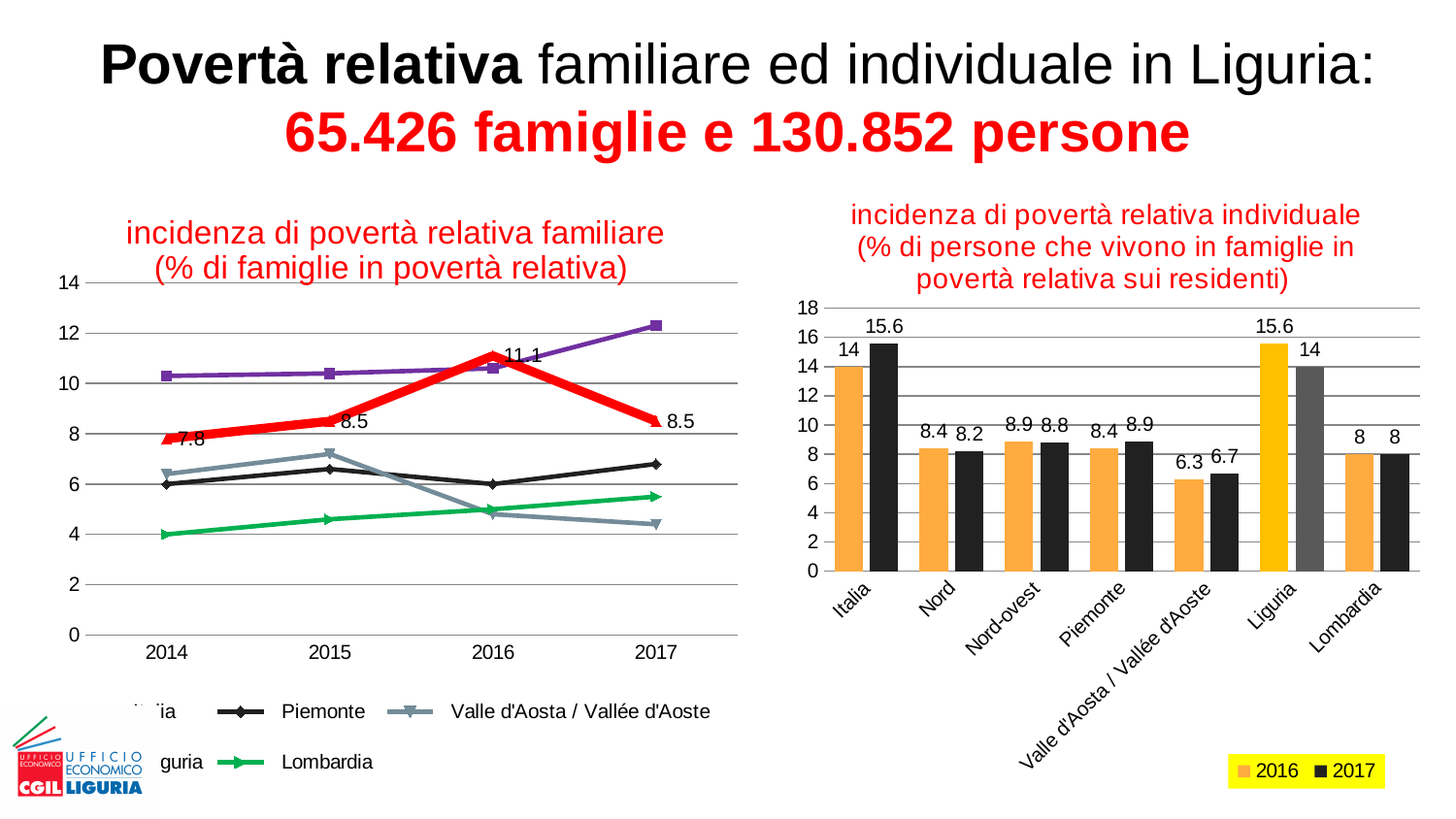
In the chart 'incidenza di povertà relativa familiare', is the value for Valle d'Aosta / Vallée d'Aoste in 2017 greater or less than 6? less In the chart 'incidenza di povertà relativa individuale', which category has the highest value for 2017? Italia In the chart 'incidenza di povertà relativa familiare', does the Lombardia line rise or fall from 2014 to 2017? rise In the chart 'incidenza di povertà relativa individuale', what is the value for Italia in 2017? 15.6 How many categories are shown on the x axis of the chart 'incidenza di povertà relativa individuale'? 7 In the chart 'incidenza di povertà relativa individuale', what is the value for Liguria in 2016? 15.6 What kind of chart is the chart on the left, 'incidenza di povertà relativa familiare'? line chart In the chart 'incidenza di povertà relativa individuale', which category has the lowest value for 2016? Valle d'Aosta / Vallée d'Aoste In the chart 'incidenza di povertà relativa individuale', what is the difference between the 2016 and 2017 values for Liguria? 1.6 In the chart 'incidenza di povertà relativa individuale', is the value for Piemonte higher in 2016 or in 2017? 2017 How many series does the legend of the chart 'incidenza di povertà relativa individuale' list? 2 In the chart 'incidenza di povertà relativa familiare', what value is labelled on the thick red line for 2016? 11.1